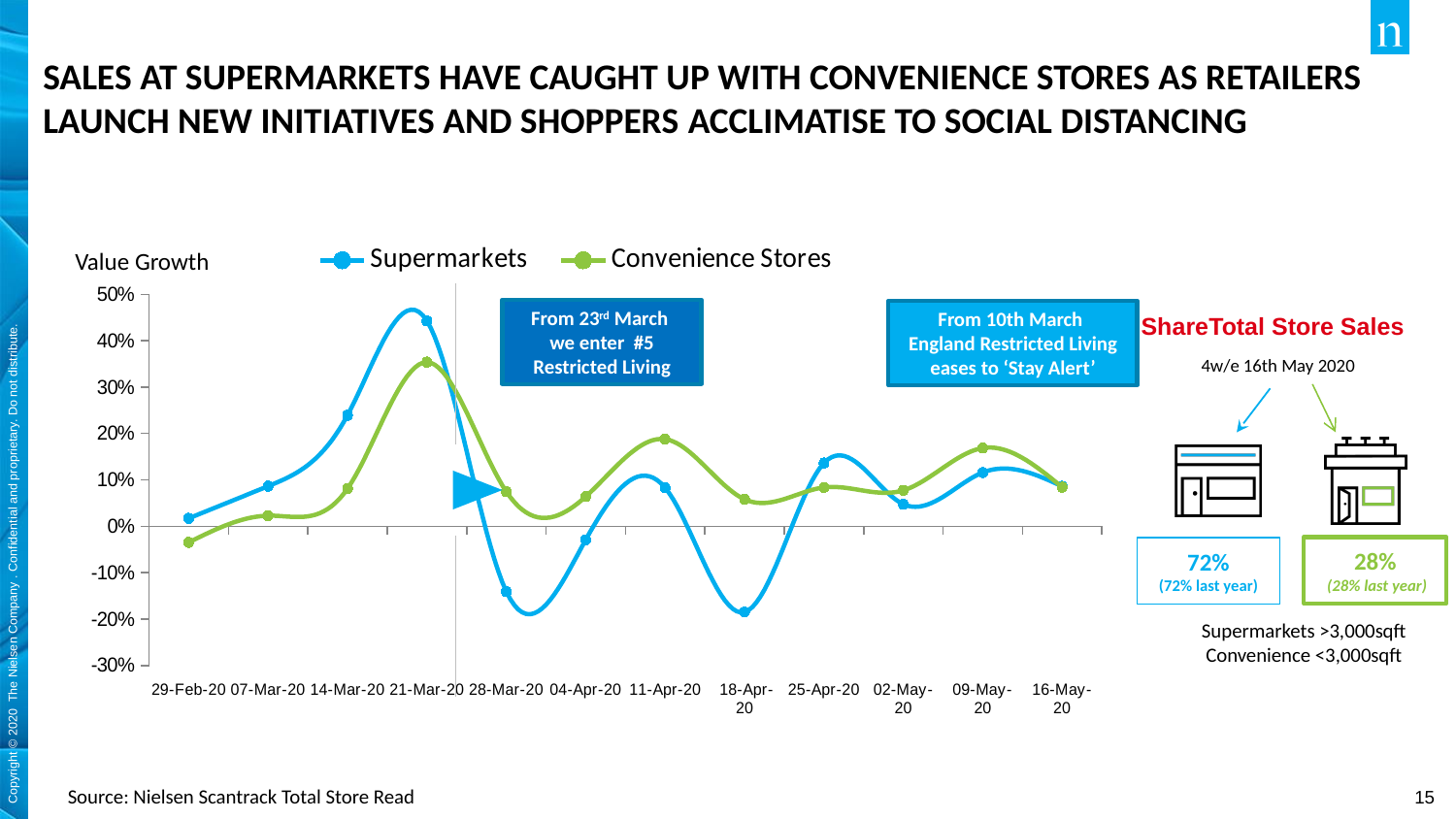
How many dates are shown along the x axis of the Value Growth chart? 12 Is the Supermarkets value on 18-Apr-20 greater or less than -10%? less On 28-Mar-20, which series has the higher value, Supermarkets or Convenience Stores? Convenience Stores Is the Supermarkets value on 21-Mar-20 greater or less than 40%? greater How many series does the legend of the Value Growth chart list? 2 On which date does the Supermarkets line reach its lowest value? 18-Apr-20 On which date does the Convenience Stores line reach its lowest value? 29-Feb-20 On which date does the Convenience Stores line reach its highest value? 21-Mar-20 What type of chart is used to show Value Growth for Supermarkets and Convenience Stores? Line chart Is the Convenience Stores value on 21-Mar-20 greater or less than 40%? less On which date does the Supermarkets line reach its highest value? 21-Mar-20 Which colour is used for the Supermarkets line in the chart? Blue